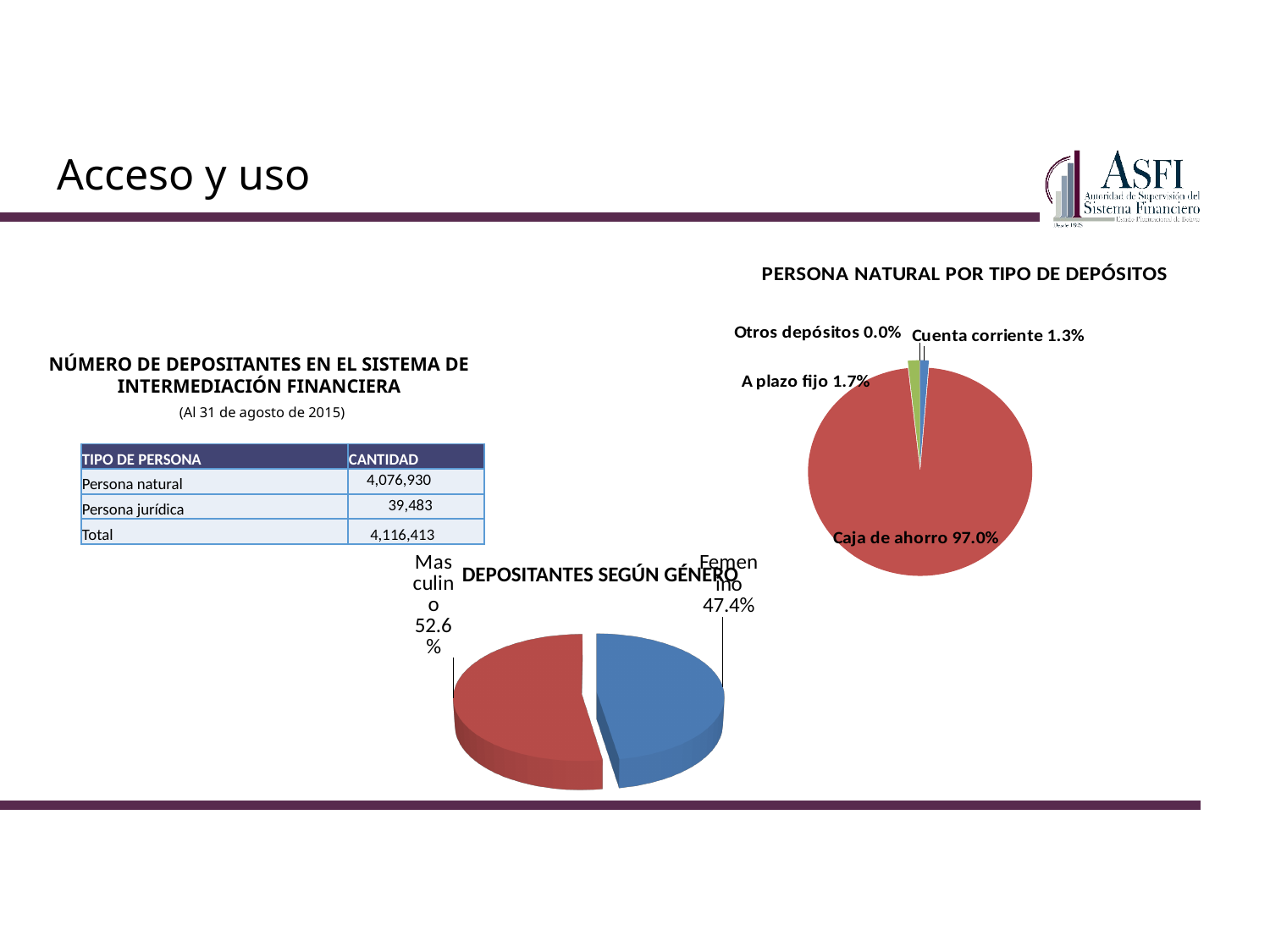
In the chart titled PERSONA NATURAL POR TIPO DE DEPÓSITOS, what share does Cuenta corriente have? 1.3% In the chart titled PERSONA NATURAL POR TIPO DE DEPÓSITOS, what is the difference between the shares of A plazo fijo and Cuenta corriente? 0.4% In the chart titled DEPOSITANTES SEGÚN GÉNERO, which gender has the larger share, Masculino or Femenino? Masculino In the chart titled PERSONA NATURAL POR TIPO DE DEPÓSITOS, which deposit type has the largest share? Caja de ahorro What kind of chart is DEPOSITANTES SEGÚN GÉNERO? Pie chart In the chart titled PERSONA NATURAL POR TIPO DE DEPÓSITOS, what share does Otros depósitos have? 0.0% In the chart titled DEPOSITANTES SEGÚN GÉNERO, what share is Femenino? 47.4% In the chart titled PERSONA NATURAL POR TIPO DE DEPÓSITOS, which deposit type has the smallest share? Otros depósitos In the chart titled PERSONA NATURAL POR TIPO DE DEPÓSITOS, how many deposit types are shown? 4